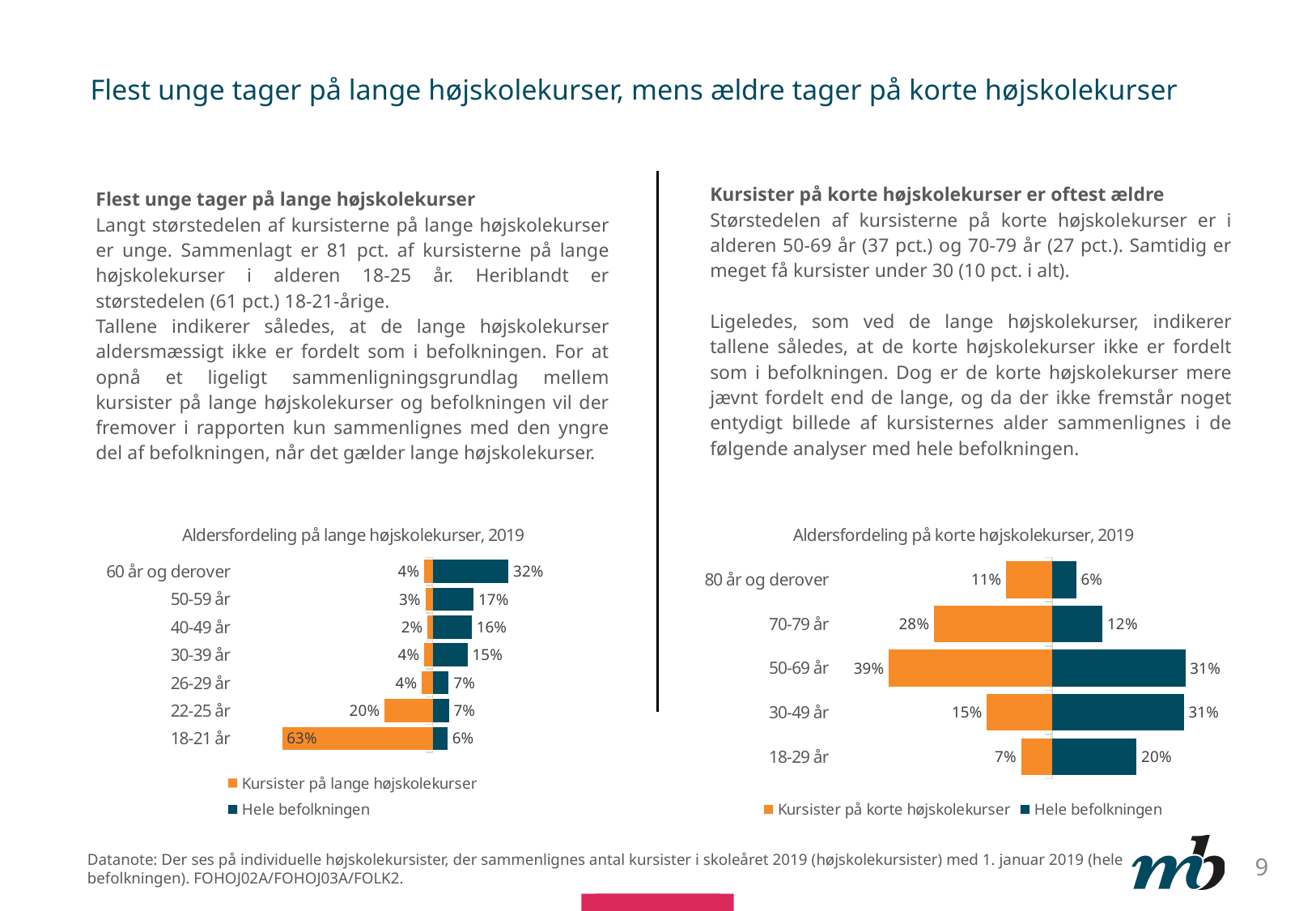
In the chart 'Aldersfordeling på lange højskolekurser, 2019', which age category has the lowest value for 'Kursister på lange højskolekurser'? 40-49 år In the chart 'Aldersfordeling på lange højskolekurser, 2019', which age category has the highest value for 'Kursister på lange højskolekurser'? 18-21 år What type of chart is 'Aldersfordeling på korte højskolekurser, 2019'? Bar chart In the chart 'Aldersfordeling på lange højskolekurser, 2019', what is the value for 'Hele befolkningen' in the 60 år og derover category? 32% In the chart 'Aldersfordeling på lange højskolekurser, 2019', what is the value for 'Kursister på lange højskolekurser' in the 18-21 år category? 63% In the chart 'Aldersfordeling på korte højskolekurser, 2019', which is larger for 70-79 år: 'Kursister på korte højskolekurser' or 'Hele befolkningen'? Kursister på korte højskolekurser In the chart 'Aldersfordeling på lange højskolekurser, 2019', what is the difference between 'Kursister på lange højskolekurser' and 'Hele befolkningen' for 18-21 år? 57 percentage points How many series does the legend list in the chart 'Aldersfordeling på korte højskolekurser, 2019'? 2 In the chart 'Aldersfordeling på korte højskolekurser, 2019', what is the value for 'Kursister på korte højskolekurser' in the 50-69 år category? 39% In the chart 'Aldersfordeling på korte højskolekurser, 2019', what is the value for 'Hele befolkningen' in the 18-29 år category? 20% How many age categories are shown in the chart 'Aldersfordeling på lange højskolekurser, 2019'? 7 In the chart 'Aldersfordeling på korte højskolekurser, 2019', what is the difference between 'Hele befolkningen' and 'Kursister på korte højskolekurser' for 30-49 år? 16 percentage points